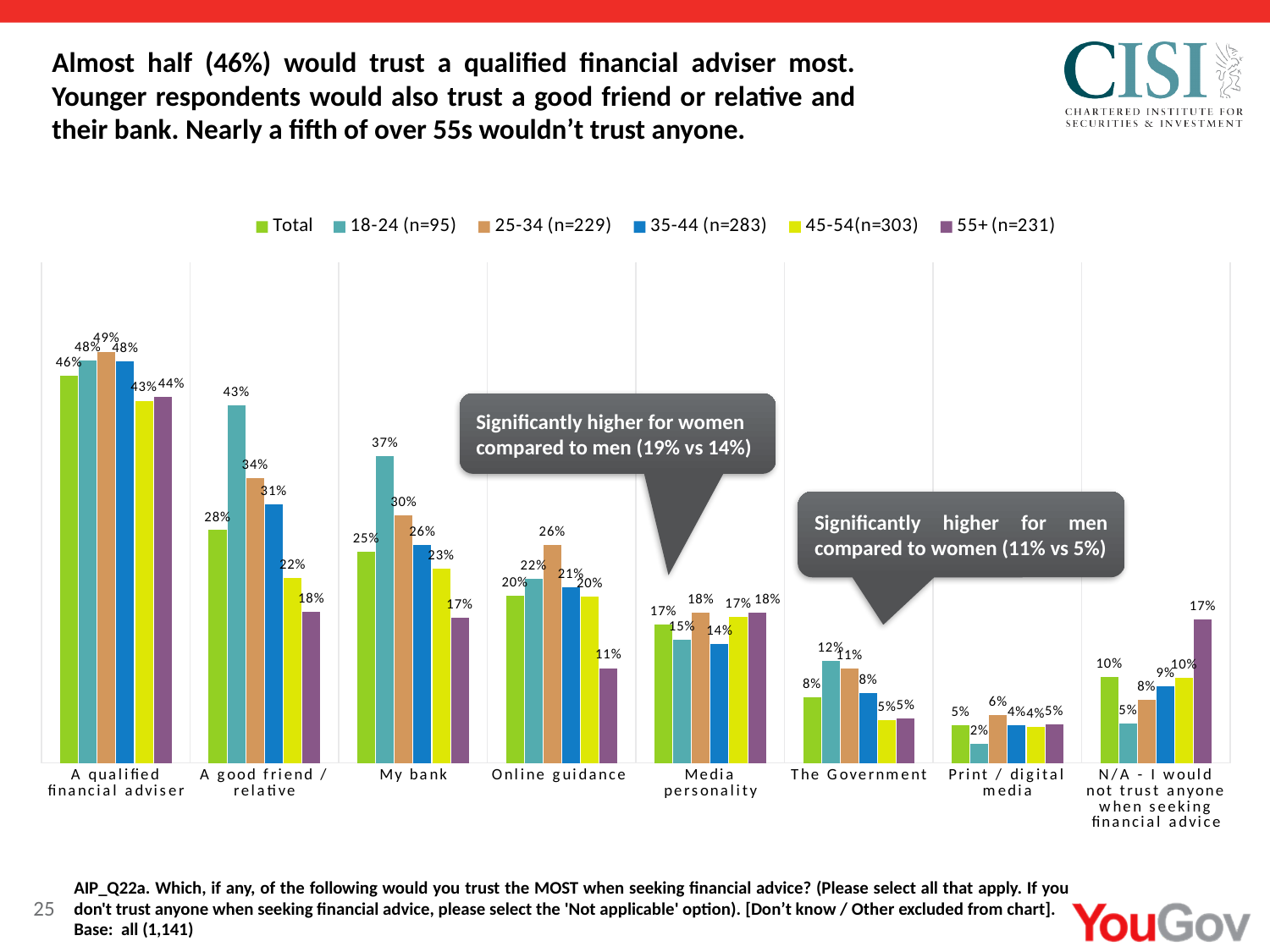
What is the value for the 18-24 (n=95) group for 'A good friend / relative'? 43% For 'Online guidance', which is larger: the 25-34 (n=229) value or the 55+ (n=231) value? 25-34 (n=229) What is the value for the 18-24 (n=95) group for 'Print / digital media'? 2% What is the value for the 18-24 (n=95) group for 'My bank'? 37% How many series does the legend list? 6 What kind of chart is shown on the slide? Bar chart What is the difference between the 18-24 (n=95) and 55+ (n=231) values for 'A good friend / relative'? 25 percentage points Which category has the highest Total value? A qualified financial adviser How many categories are shown on the x axis? 8 What is the Total value for 'A qualified financial adviser'? 46% Which category has the lowest Total value? Print / digital media What is the value for the 55+ (n=231) group for 'N/A - I would not trust anyone when seeking financial advice'? 17%